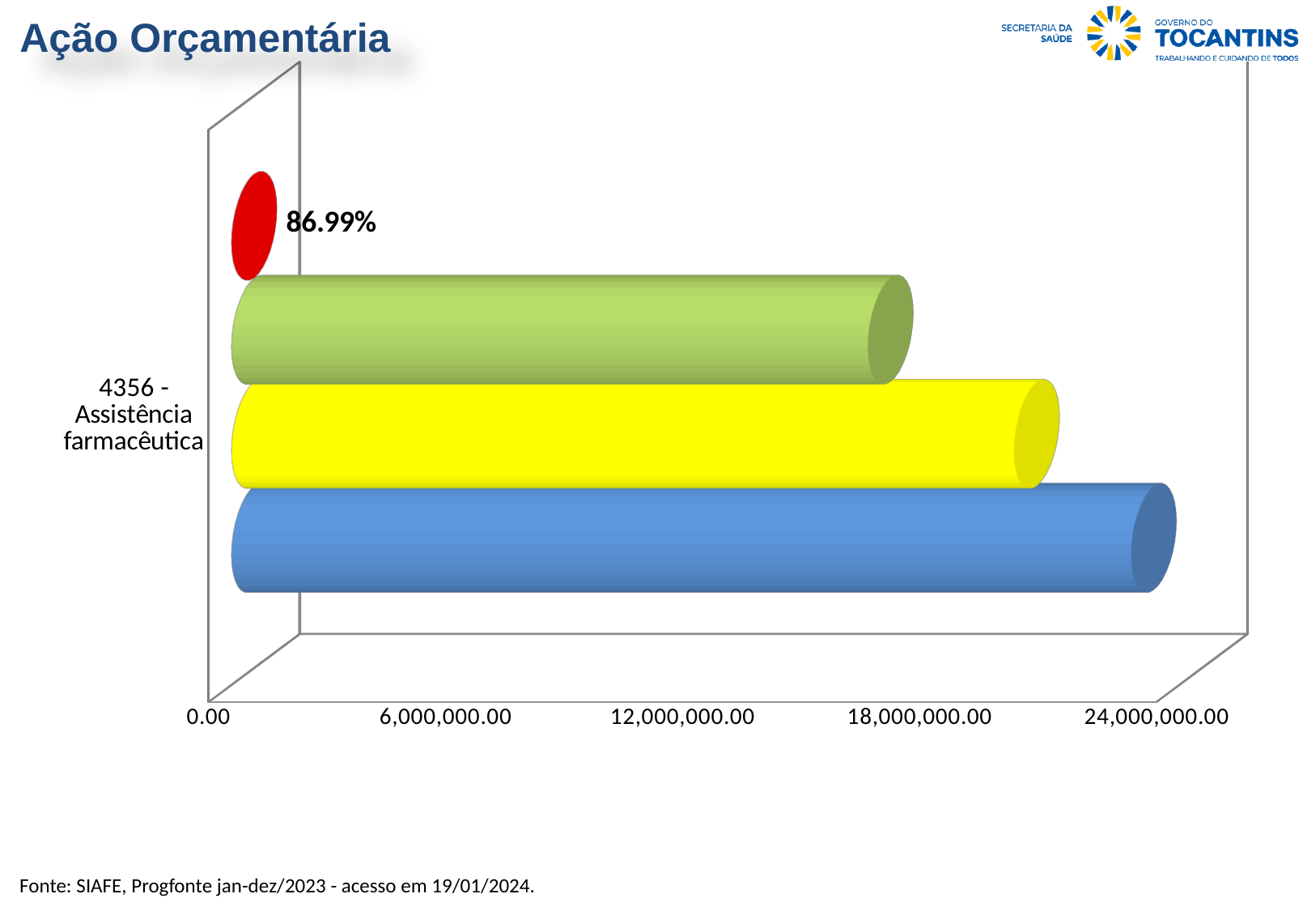
Which coloured bar is the shortest in the chart? green How many categories are shown on the vertical axis of the chart? 1 What kind of chart is shown on the slide? bar chart Which coloured bar is the longest in the chart? blue What category label is shown on the vertical axis of the chart? 4356 - Assistência farmacêutica Is the value of the blue bar greater or less than 18,000,000.00? greater What is the title of the slide containing the chart? Ação Orçamentária Is the value of the green bar greater or less than 18,000,000.00? less What percentage is printed next to the red oval on the chart? 86.99% Is the value of the yellow bar greater or less than 18,000,000.00? greater How many bars are plotted in the chart? 3 Which is larger, the value of the yellow bar or the value of the green bar? yellow bar